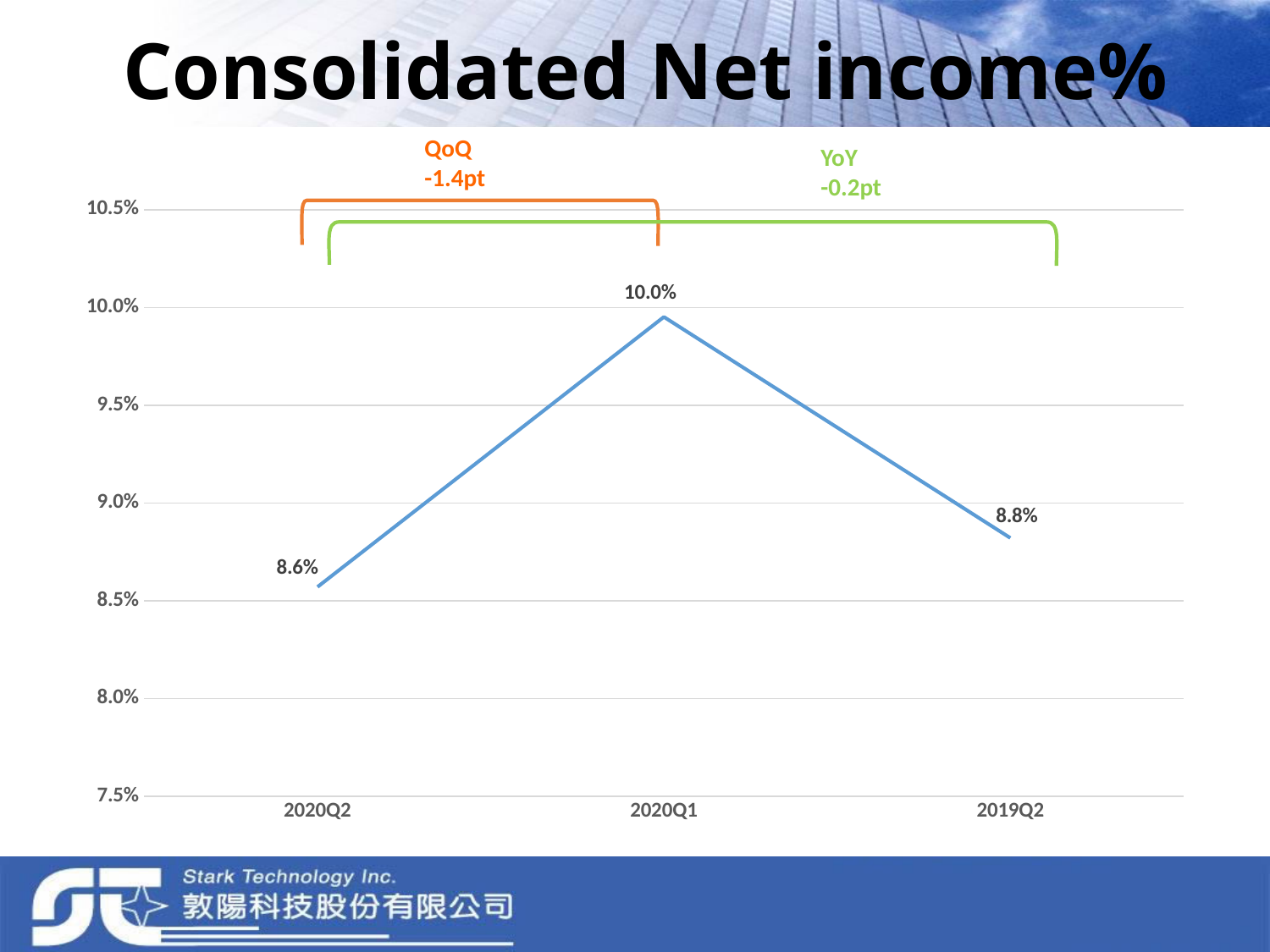
What is the consolidated net income % for 2020Q1? 10.0% Which is larger, the consolidated net income % for 2020Q1 or for 2019Q2? 2020Q1 What is the consolidated net income % for 2019Q2? 8.8% What is the consolidated net income % for 2020Q2? 8.6% What QoQ change is annotated on the chart? -1.4pt What kind of chart is shown on the slide? Line chart Which period has the highest consolidated net income %? 2020Q1 Which period has the lowest consolidated net income %? 2020Q2 What is the difference in consolidated net income % between 2019Q2 and 2020Q2? 0.2pt What is the difference in consolidated net income % between 2020Q1 and 2020Q2? 1.4pt Is the value for 2020Q2 greater or less than 9.0%? less How many periods are plotted on the chart? 3